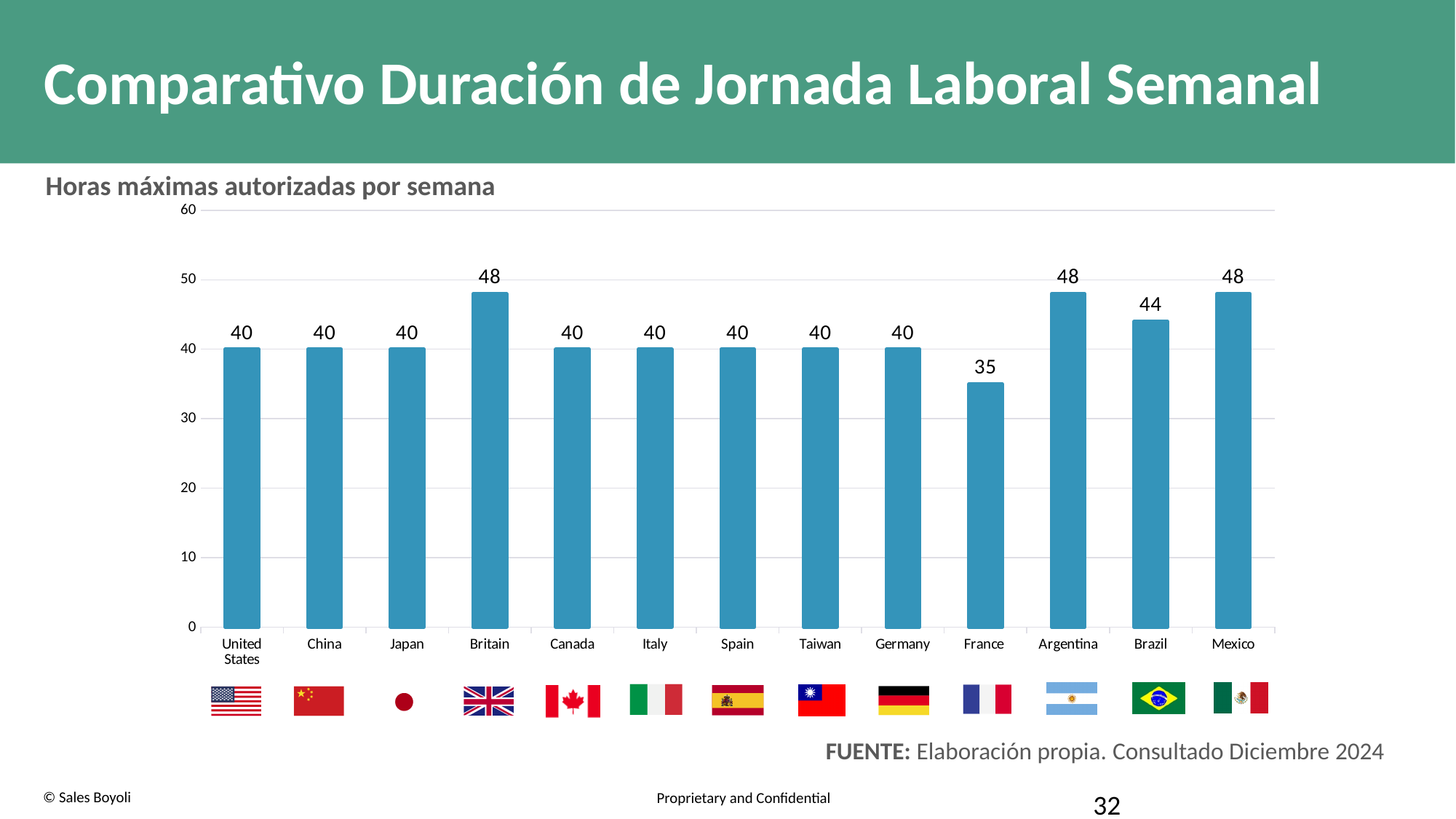
What is the difference between the values for Mexico and France? 13 Which country has the lowest value? France What kind of chart is shown on the slide? Bar chart What is the difference between the values for Brazil and Canada? 4 What is the value for Germany? 40 What is the value for Brazil? 44 What is the value for Britain? 48 Which is larger, the value for France or the value for Japan? Japan How many countries are shown in the chart? 13 What is the value for France? 35 Which is larger, the value for Argentina or the value for Brazil? Argentina What is the subtitle shown above the chart? Horas máximas autorizadas por semana